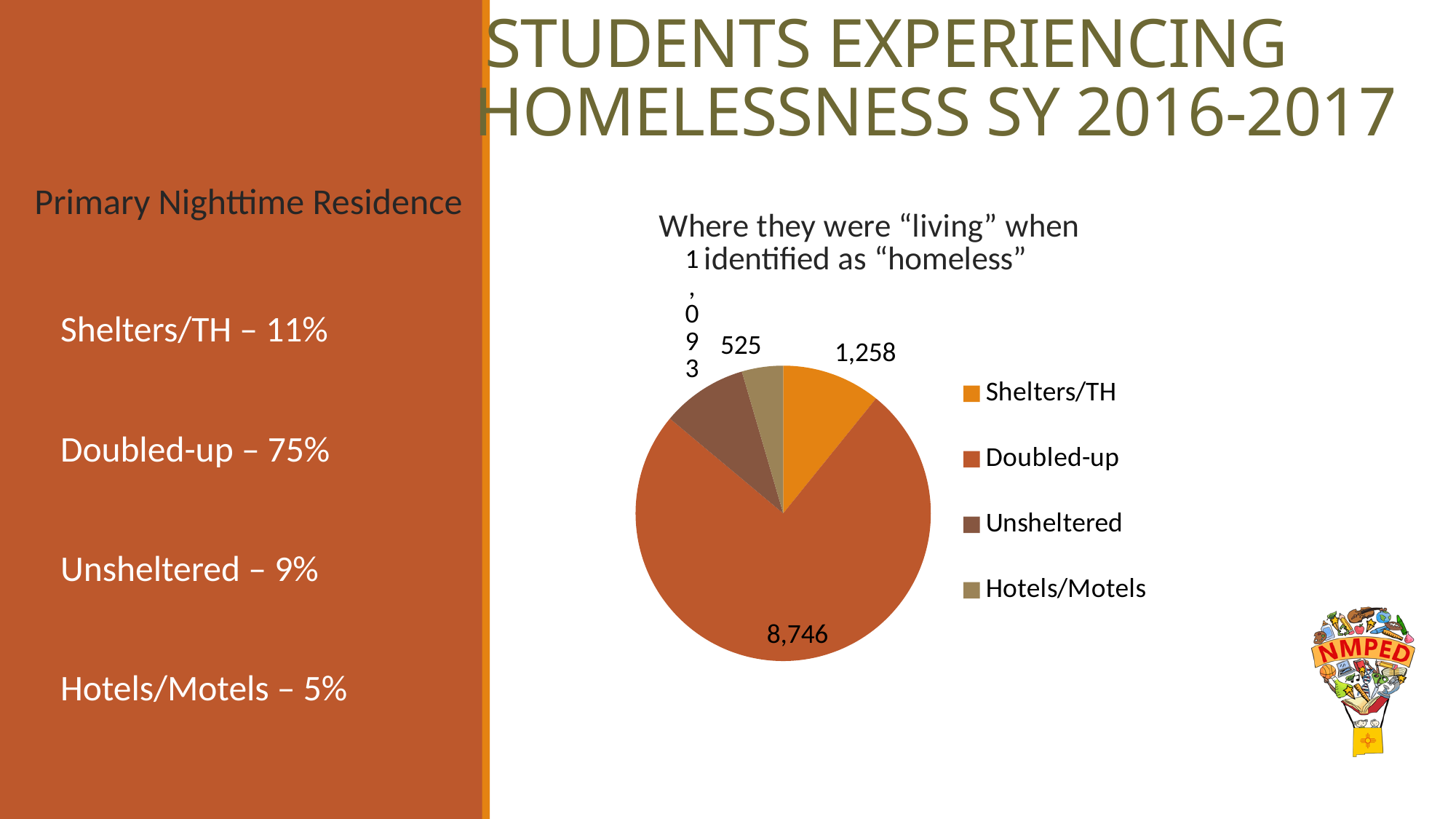
Which category has the largest slice of the pie chart? Doubled-up What is the value for Doubled-up in the pie chart? 8,746 What is the difference between the Doubled-up value and the Shelters/TH value? 7,488 What type of chart is shown on the slide? pie chart What is the value for Hotels/Motels in the pie chart? 525 Which is larger, the value for Shelters/TH or the value for Unsheltered? Shelters/TH What is the value for Unsheltered in the pie chart? 1,093 How many categories does the pie chart legend list? 4 Which category has the smallest slice of the pie chart? Hotels/Motels What is the value for Shelters/TH in the pie chart? 1,258 What share of the pie does Doubled-up represent? 75% What is the title of the pie chart? Where they were "living" when identified as "homeless"